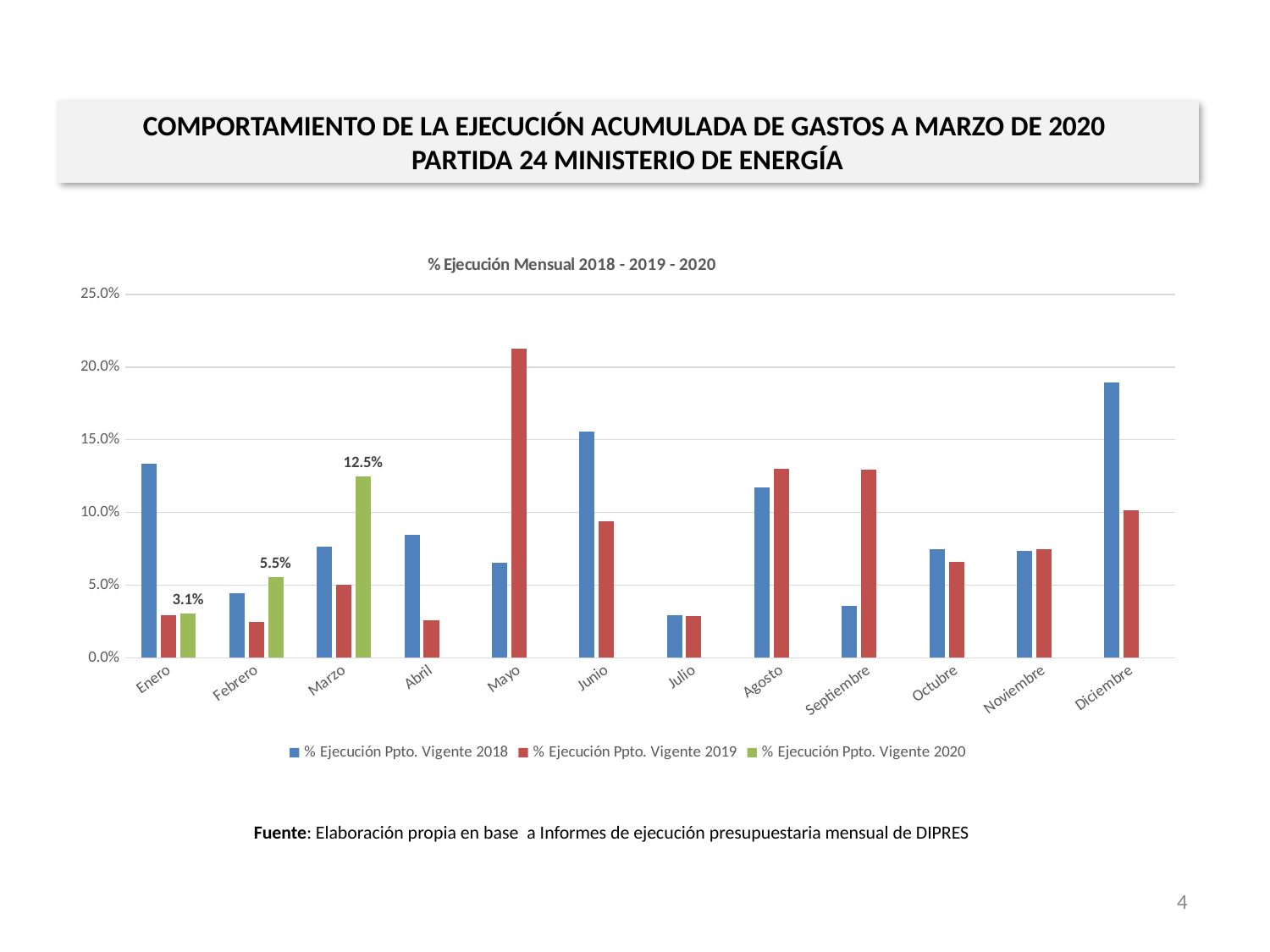
What is the value for % Ejecución Ppto. Vigente 2020 in Marzo? 12.5% What is the difference between the 2020 values for Marzo and Febrero? 7.0% How many series does the legend list? 3 Which month has the highest value for % Ejecución Ppto. Vigente 2019? Mayo What is the value for % Ejecución Ppto. Vigente 2020 in Enero? 3.1% What is the value for % Ejecución Ppto. Vigente 2020 in Febrero? 5.5% Is the value for % Ejecución Ppto. Vigente 2019 in Mayo greater or less than 20.0%? greater In Junio, which series has the larger value: % Ejecución Ppto. Vigente 2018 or % Ejecución Ppto. Vigente 2019? % Ejecución Ppto. Vigente 2018 What kind of chart is shown on the slide? Bar chart Is the value for % Ejecución Ppto. Vigente 2018 in Diciembre greater or less than 15.0%? greater How many months are shown on the x axis? 12 Which month has the highest value for % Ejecución Ppto. Vigente 2020? Marzo